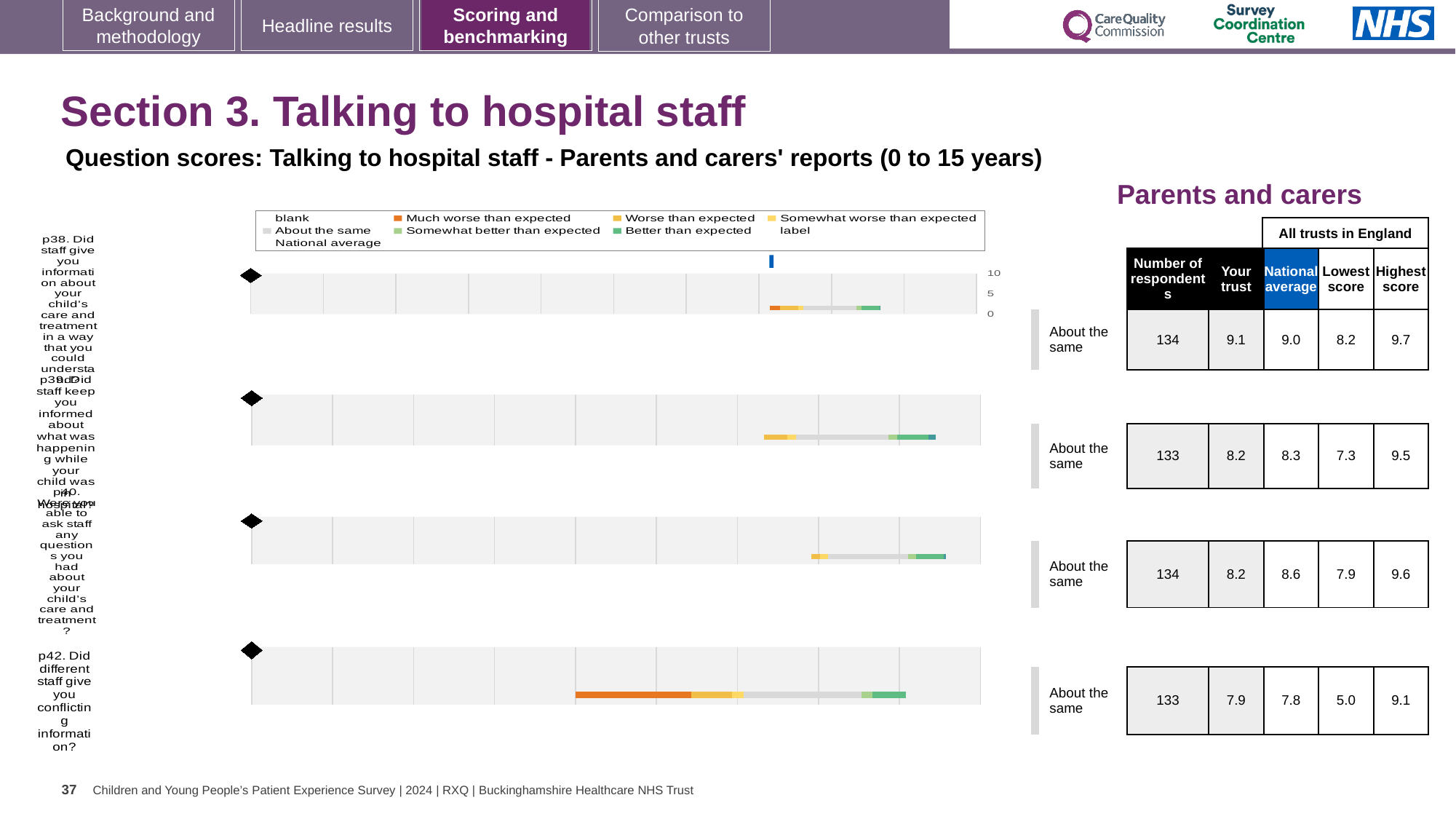
What benchmark category is shown beside the p42 chart? About the same In the table next to the p42 chart, what is the National average score? 7.8 How many entries does the chart legend list? 9 In the table next to the p38 chart, what is the 'Your trust' score? 9.1 Which question has the highest 'Your trust' score? p38 For p42, what is the difference between the Highest score and the Lowest score? 4.1 For p40, which is larger: the 'Your trust' score or the National average? National average Which question has the lowest 'Lowest score' value in the table? p42 In the table next to the p39 chart, how many respondents are listed? 133 How many question charts are shown on the slide? 4 What kind of chart is used to show the question scores on this slide? bar chart What is the heading above the National average, Lowest score and Highest score columns? All trusts in England